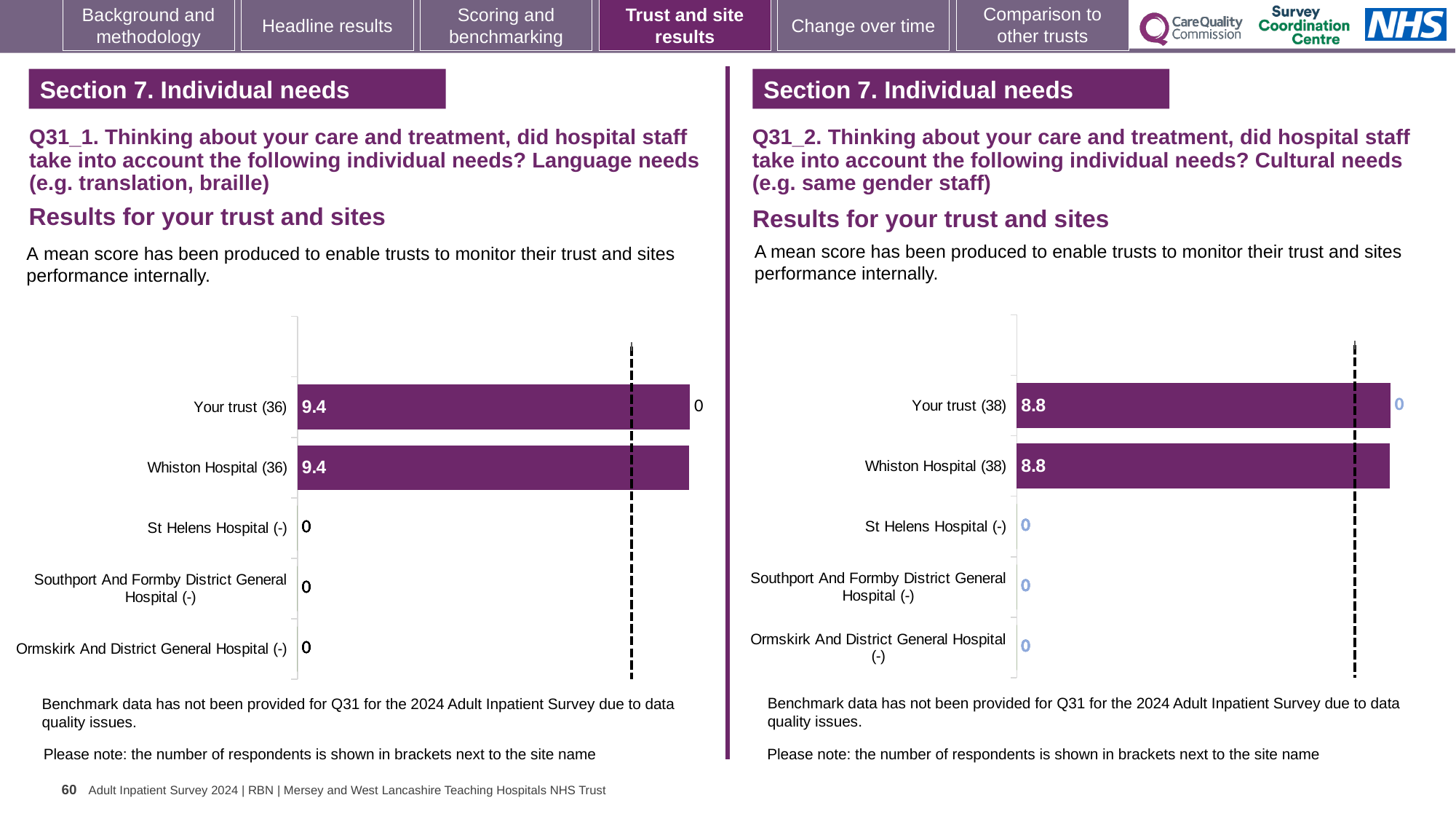
In the Q31_1 Language needs chart on the left, what is the difference between the scores for Your trust (36) and Whiston Hospital (36)? 0 In the Q31_1 Language needs chart on the left, what is the mean score for Whiston Hospital (36)? 9.4 How many respondents are shown in brackets for Your trust in the Q31_2 Cultural needs chart on the right? 38 In the Q31_1 Language needs chart on the left, what is the mean score for Your trust (36)? 9.4 How many categories are plotted in the Q31_1 Language needs chart on the left? 5 How many categories are plotted in the Q31_2 Cultural needs chart on the right? 5 In the Q31_2 Cultural needs chart on the right, what is the mean score for Your trust (38)? 8.8 What type of chart is used in the Q31_1 Language needs chart on the left? Bar chart In the Q31_2 Cultural needs chart on the right, what value is shown for St Helens Hospital (-)? 0 In the Q31_2 Cultural needs chart on the right, what is the mean score for Whiston Hospital (38)? 8.8 Which is larger: the Your trust score in the Q31_1 Language needs chart on the left or the Your trust score in the Q31_2 Cultural needs chart on the right? Q31_1 Language needs (9.4) What is the difference between the Your trust score in the Q31_1 Language needs chart (left) and the Your trust score in the Q31_2 Cultural needs chart (right)? 0.6